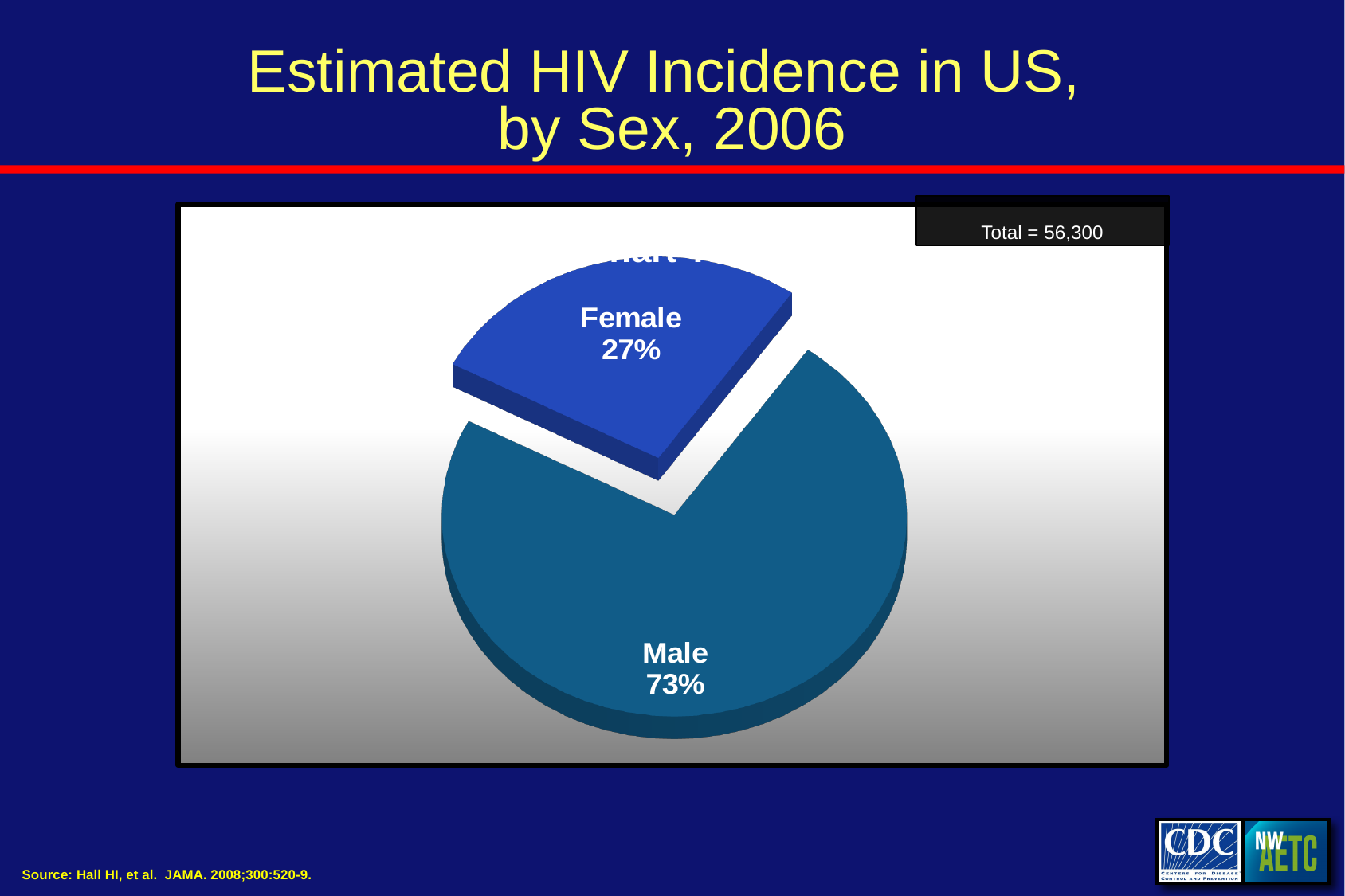
Is the Female share greater or less than 50%? less What percentage of estimated HIV incidence in the US in 2006 is attributed to males? 73% Is the Male slice larger or smaller than the Female slice? larger What percentage of estimated HIV incidence in the US in 2006 is attributed to females? 27% Which sex accounts for the smaller share of the pie? Female What kind of chart is shown on the slide? pie chart Which sex accounts for the larger share of the pie? Male How many slices does the pie chart have? 2 Which slice is exploded (pulled out) from the pie? Female What total number of estimated HIV cases is shown on the slide? 56,300 What is the difference in percentage points between the Male and Female slices? 46